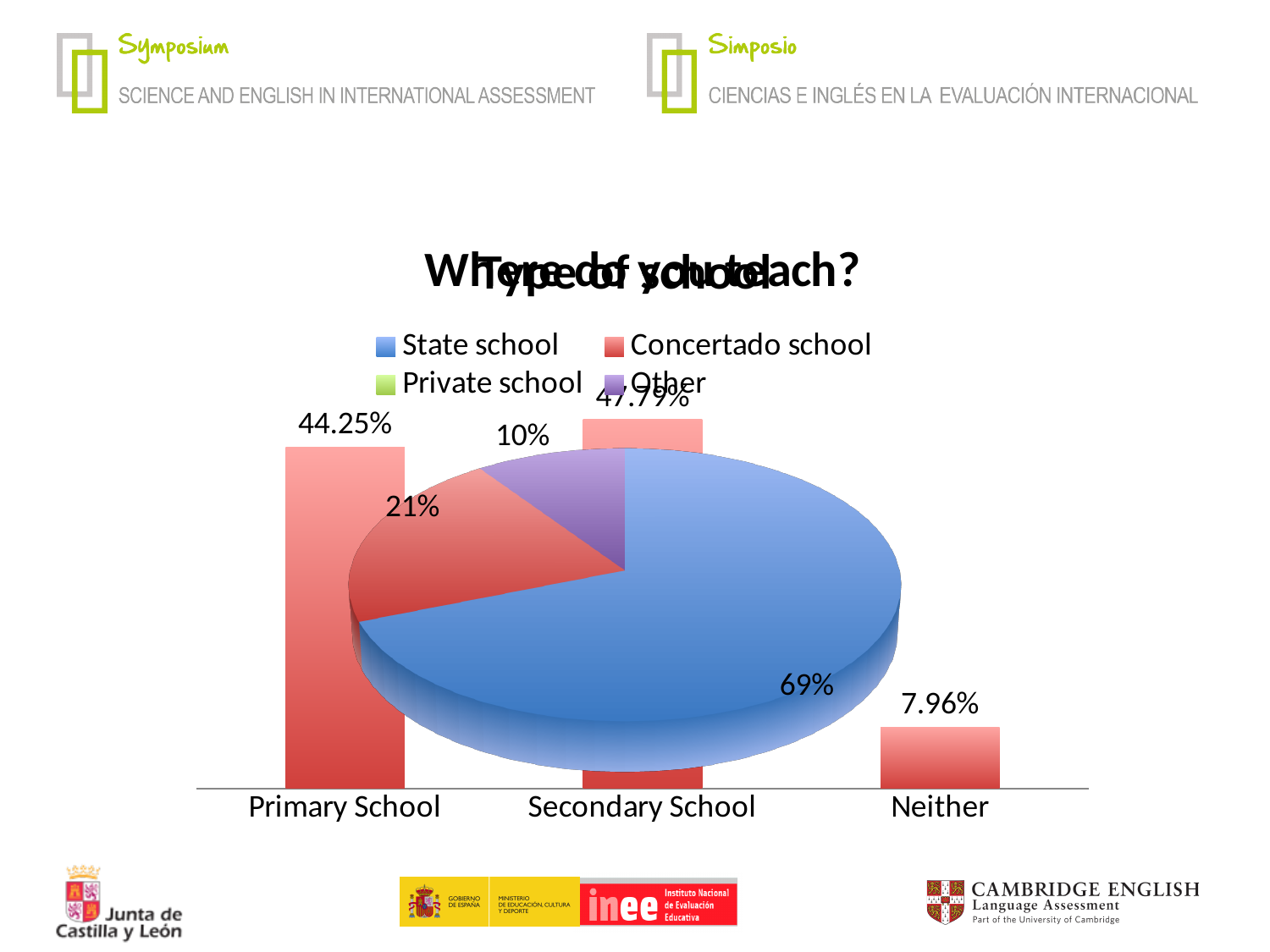
In the bar chart, what is the difference between the values for Primary School and Neither? 36.29% In the bar chart, what is the value for Neither? 7.96% In the pie chart, what share does Other have? 10% In the pie chart, which is larger, the Concertado school slice or the Other slice? Concertado school In the bar chart, which category has the highest value? Secondary School In the bar chart, what is the value for Primary School? 44.25% In the bar chart, how many categories are shown on the x axis? 3 In the bar chart, which category has the lowest value? Neither In the bar chart, what is the value for Secondary School? 47.79% In the pie chart, what share does Concertado school have? 21% How many entries does the pie chart's legend list? 4 In the pie chart, what share does State school have? 69%